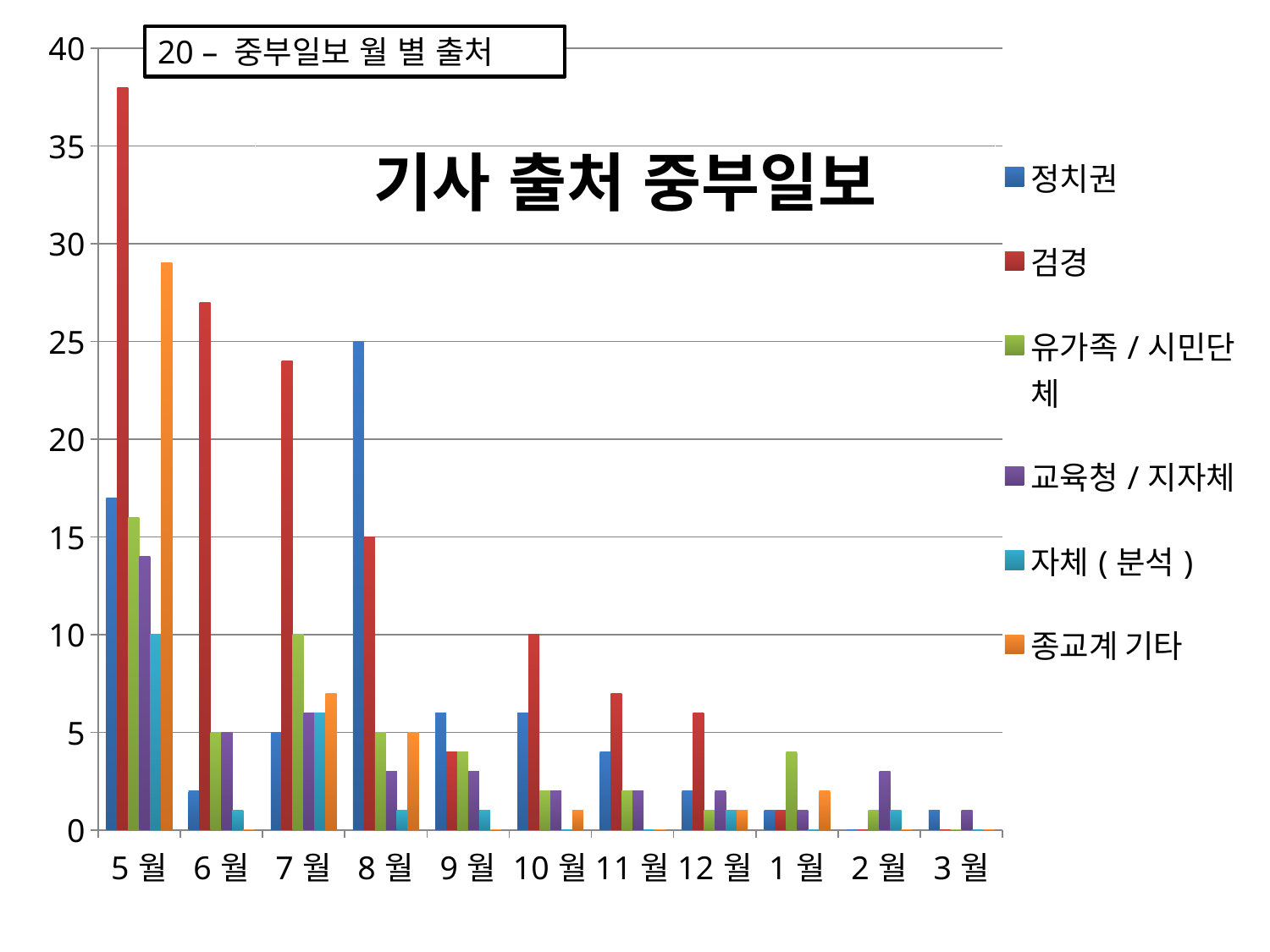
In 7 월, which is larger, the value for 검경 or the value for 유가족 / 시민단체? 검경 How many series does the legend list? 6 Is the value for 검경 in 6 월 greater or less than 25? greater What kind of chart is shown on the slide? bar chart Which month has the highest value for 검경? 5 월 Is the value for 종교계 기타 in 5 월 greater or less than 25? greater How many month categories are shown on the x axis? 11 Is the value for 검경 in 5 월 greater or less than 35? greater Which month has the highest value for 정치권? 8 월 What is the title shown in the box at the top left of the chart? 20 – 중부일보 월 별 출처 In 8 월, which is larger, the value for 정치권 or the value for 검경? 정치권